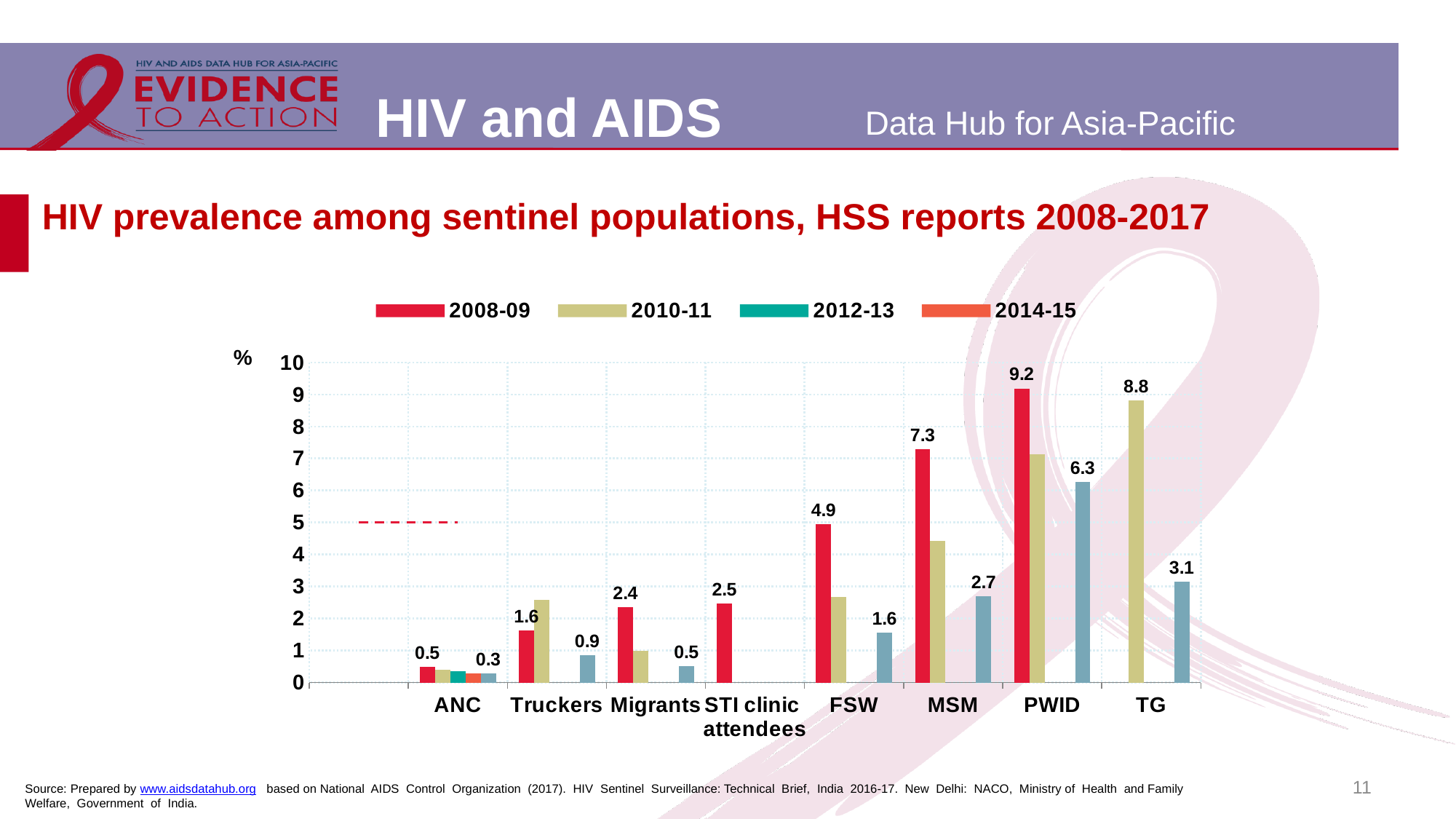
Which population has the lowest 2008-09 value? ANC What is the difference between the 2008-09 values for FSW and Truckers? 3.3 Which has the larger 2008-09 value, Migrants or STI clinic attendees? STI clinic attendees What is the 2010-11 value shown for TG? 8.8 How many sentinel populations are shown on the x axis? 8 Which population has the highest 2008-09 value? PWID What is the 2008-09 value shown for STI clinic attendees? 2.5 Is the 2010-11 value for PWID greater or less than 5? greater What is the difference between the 2008-09 values for PWID and MSM? 1.9 What is the 2008-09 value shown for MSM? 7.3 How many series does the legend list? 4 What is the 2008-09 HIV prevalence value shown for PWID? 9.2